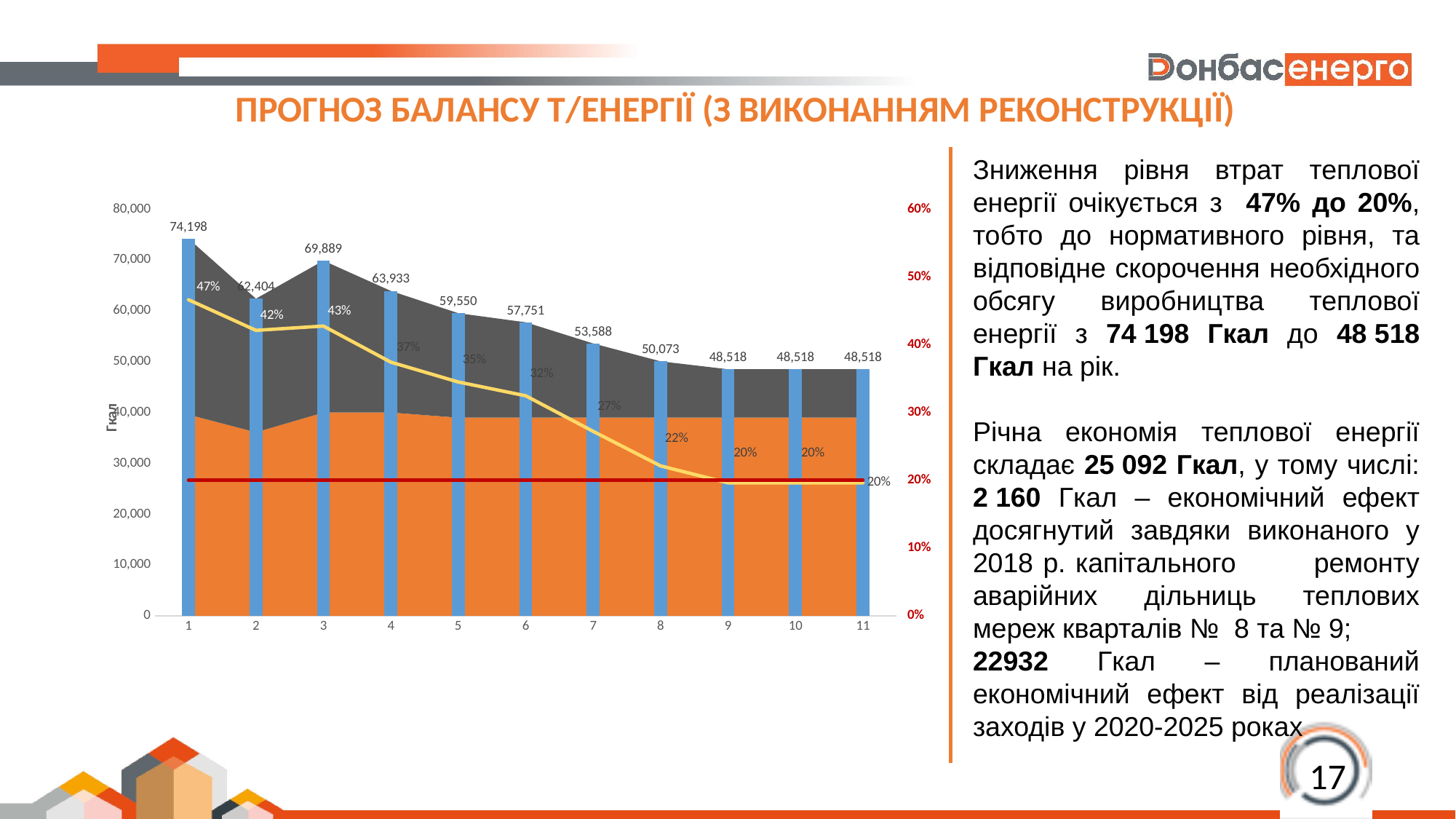
Do the percentage values on the line generally rise or fall from category 1 to category 11? fall What is the lowest bar value shown on the chart? 48,518 What percentage is shown on the line for category 7? 27% What is the bar value for category 1? 74,198 What percentage is shown on the line for category 4? 37% What is the bar value for category 3? 69,889 What is the label on the left vertical axis? Гкал Which is larger, the bar value for category 2 or for category 3? category 3 How many categories are shown on the x axis? 11 Which category has the highest bar value? 1 What is the difference between the bar values for category 1 and category 11? 25,680 What is the bar value for category 8? 50,073